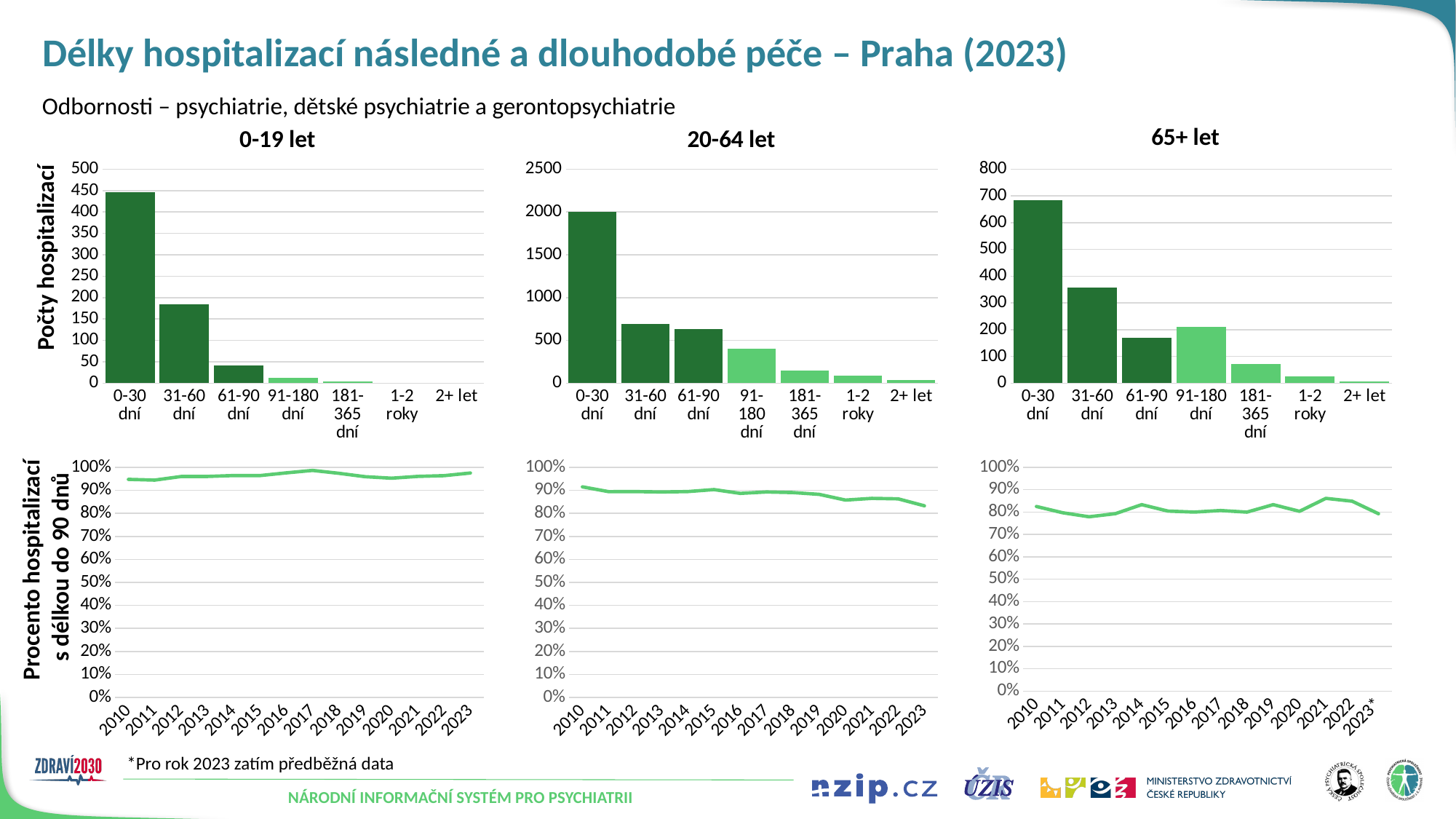
In the top-left bar chart '0-19 let', is the value for 0-30 dní greater or less than 400? greater What kind of chart is the bottom-middle chart for '20-64 let' showing 'Procento hospitalizací s délkou do 90 dnů'? line chart In the top-right bar chart '65+ let', which is larger, the value for 61-90 dní or the value for 91-180 dní? 91-180 dní In the top-right bar chart '65+ let', is the value for 0-30 dní greater or less than 600? greater In the top-left bar chart '0-19 let', is the value for 61-90 dní greater or less than 50? less In the top-middle bar chart '20-64 let', which category has the lowest value? 2+ let In the bottom-middle line chart for '20-64 let', do the values generally rise or fall from 2010 to 2023? fall How many categories are shown on the x axis of the top-middle bar chart '20-64 let'? 7 In the top-left bar chart '0-19 let', which category has the highest value? 0-30 dní What kind of chart is the top-left chart titled '0-19 let'? bar chart